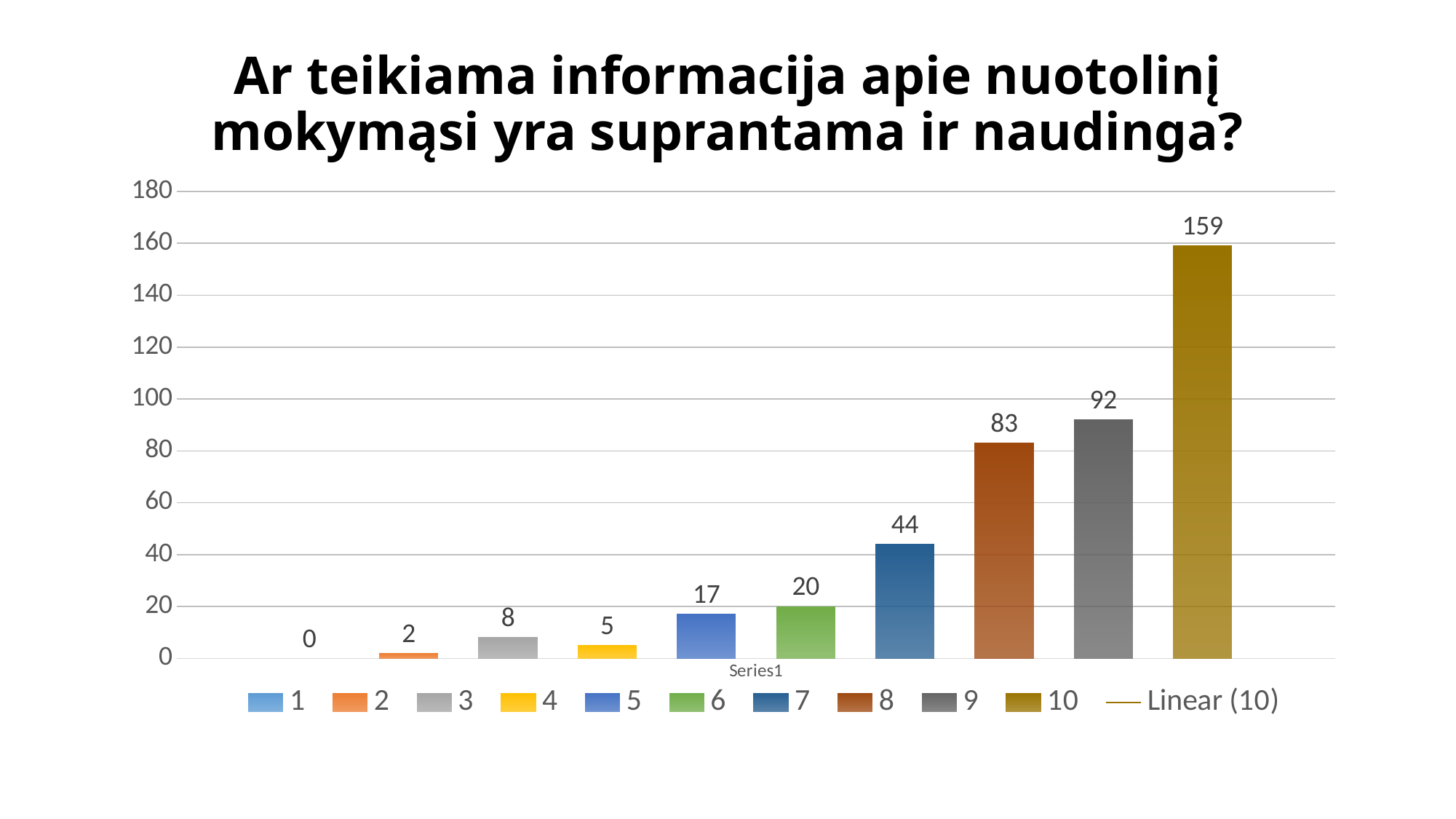
Is the value for rating 9 greater or less than 100? less Which rating has the lowest value? 1 What is the difference between the values for rating 8 and rating 7? 39 What is the value for rating 7? 44 Do the values generally rise or fall from rating 1 to rating 10? rise What kind of chart is shown on the slide? bar chart What is the value for rating 3? 8 Which rating has the highest value? 10 Which is larger, the value for rating 5 or the value for rating 6? 6 How many bars are shown in the chart? 10 What is the value for rating 10? 159 What is the difference between the values for rating 10 and rating 9? 67